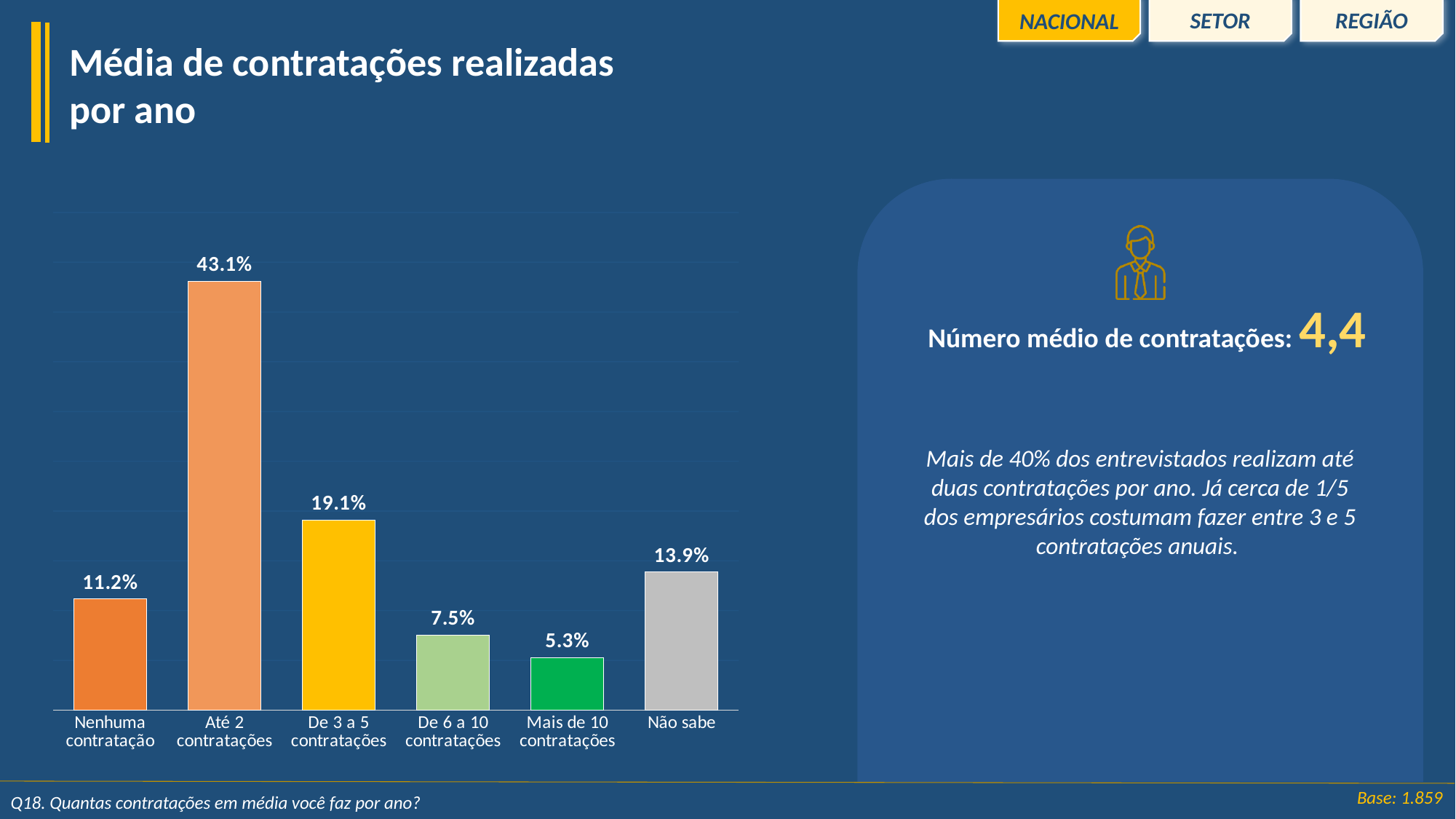
Which category has the highest value? Até 2 contratações Which is larger, the value for 'De 6 a 10 contratações' or the value for 'Mais de 10 contratações'? De 6 a 10 contratações What is the difference between the values for 'Até 2 contratações' and 'De 3 a 5 contratações'? 24.0% How many categories are shown in the chart? 6 What is the value for 'Até 2 contratações'? 43.1% What is the title of the slide? Média de contratações realizadas por ano Which category has the lowest value? Mais de 10 contratações What is the difference between the values for 'Não sabe' and 'Nenhuma contratação'? 2.7% What is the value for 'Não sabe'? 13.9% What is the value for 'Mais de 10 contratações'? 5.3% What is the value for 'Nenhuma contratação'? 11.2% What kind of chart is shown on the slide? Bar chart